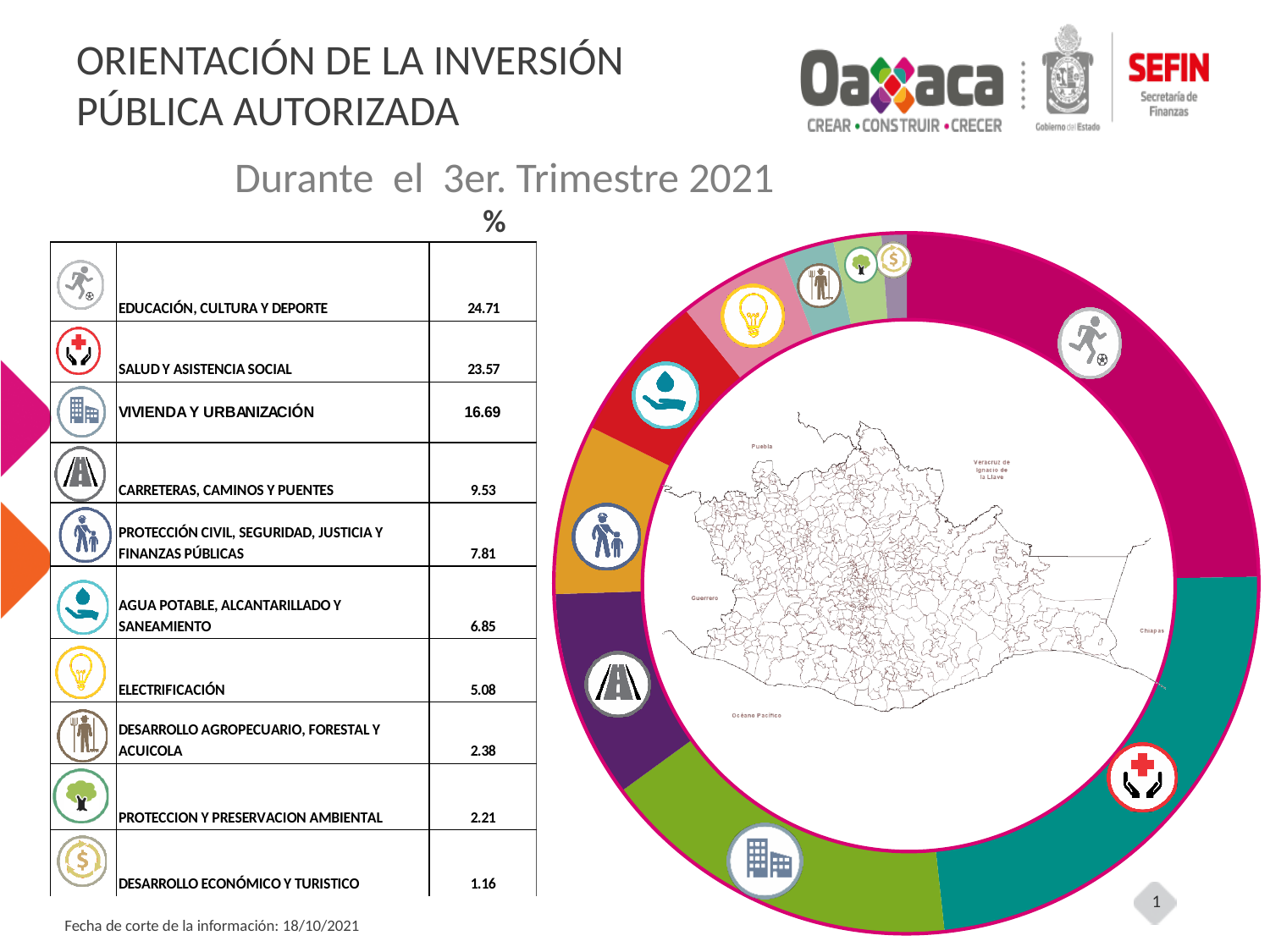
What is the difference in percentage points between PROTECCION Y PRESERVACION AMBIENTAL and DESARROLLO ECONÓMICO Y TURISTICO? 1.05 What percentage is shown for EDUCACIÓN, CULTURA Y DEPORTE? 24.71 What kind of chart is shown on the right side of the slide? Donut (pie) chart What percentage is shown for SALUD Y ASISTENCIA SOCIAL? 23.57 What period does the chart cover, according to the subtitle? 3er. Trimestre 2021 Which is larger, the share for CARRETERAS, CAMINOS Y PUENTES or the share for AGUA POTABLE, ALCANTARILLADO Y SANEAMIENTO? CARRETERAS, CAMINOS Y PUENTES What percentage is shown for ELECTRIFICACIÓN? 5.08 What is the difference in percentage points between EDUCACIÓN, CULTURA Y DEPORTE and SALUD Y ASISTENCIA SOCIAL? 1.14 Which category has the highest share of the authorized public investment? EDUCACIÓN, CULTURA Y DEPORTE What percentage is shown for VIVIENDA Y URBANIZACIÓN? 16.69 How many categories are listed in the table of authorized public investment? 10 Which category has the lowest share of the authorized public investment? DESARROLLO ECONÓMICO Y TURISTICO